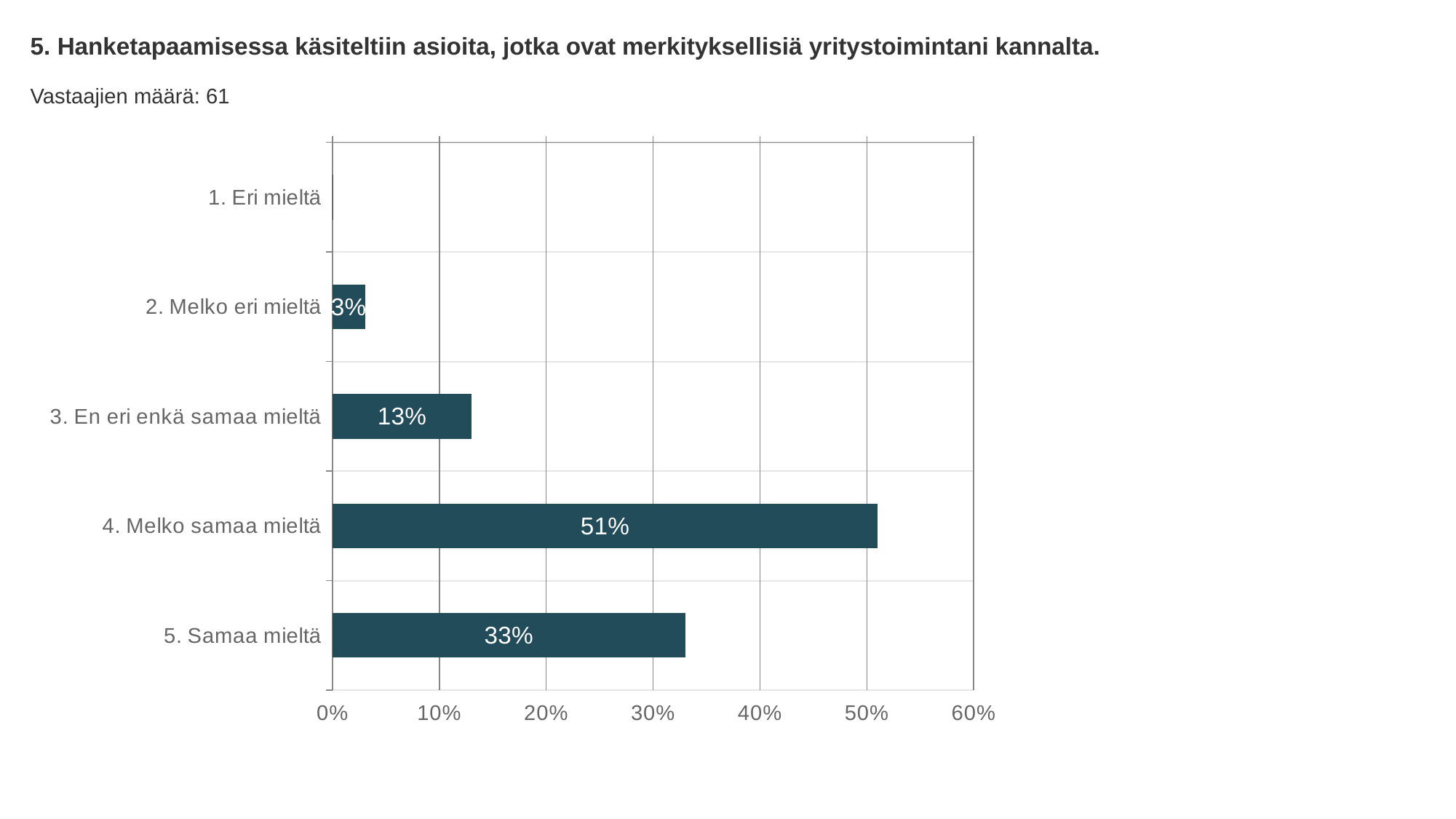
Is the value for "4. Melko samaa mieltä" greater or less than 50%? greater What is the value for "2. Melko eri mieltä"? 3% Which is larger, the value for "3. En eri enkä samaa mieltä" or the value for "5. Samaa mieltä"? 5. Samaa mieltä What is the value for "4. Melko samaa mieltä"? 51% How many respondents (Vastaajien määrä) are reported on the slide? 61 How many categories are shown on the chart? 5 What is the value for "5. Samaa mieltä"? 33% What is the difference between the values for "4. Melko samaa mieltä" and "5. Samaa mieltä"? 18% Is the value for "1. Eri mieltä" greater or less than 10%? less Which category has the highest value? 4. Melko samaa mieltä What kind of chart is shown on the slide? Bar chart What is the value for "3. En eri enkä samaa mieltä"? 13%